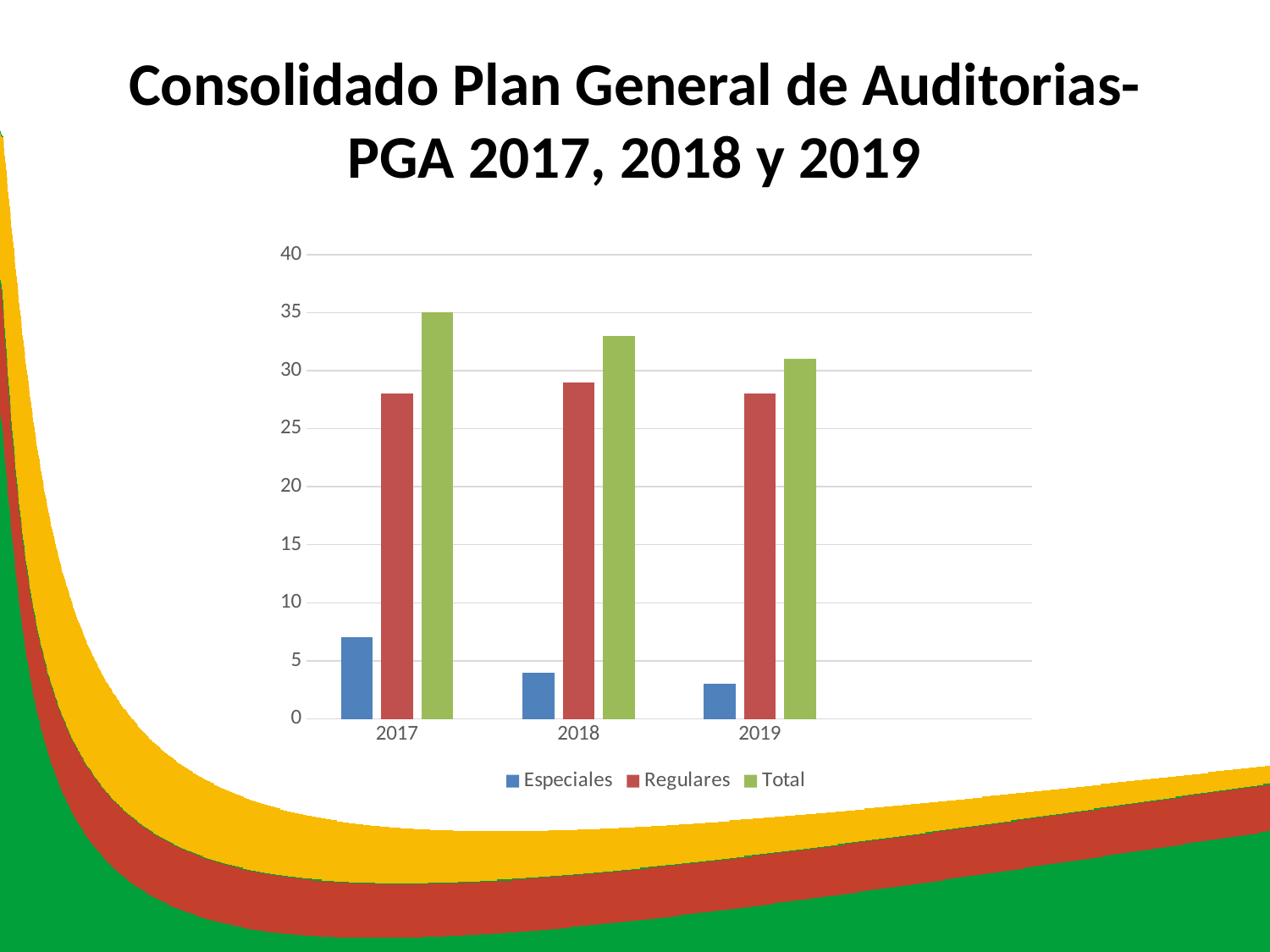
Is the Especiales value for 2018 greater or less than 5? less Which year has the highest Especiales value? 2017 Do the Total values rise or fall from 2017 to 2019? fall How many series does the legend list? 3 Is the Especiales value for 2017 greater or less than 5? greater How many years are shown on the x axis? 3 Which year has the highest Total value? 2017 Is the Regulares value for 2017 greater or less than 25? greater Which is larger, the Total value for 2017 or the Total value for 2019? 2017 Which colour represents the Total series in the legend? green What kind of chart is shown on the slide? bar chart